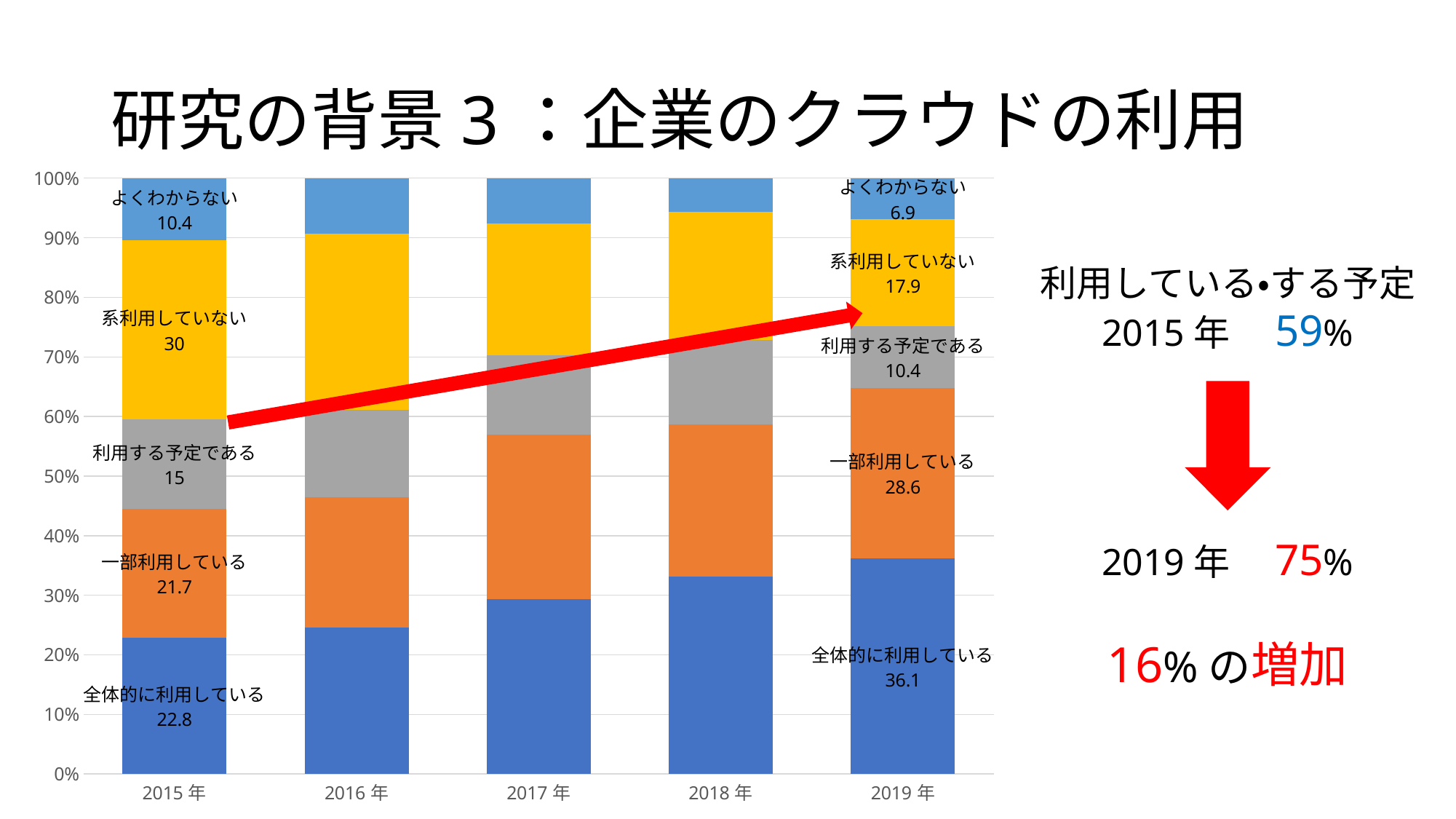
Is the 全体的に利用している segment for 2018年 greater or less than 30%? greater How many years are shown along the x axis of the chart? 5 What is the value of 一部利用している for 2019年? 28.6 What kind of chart is shown on the slide? stacked bar chart What is the value of 系利用していない for 2015年? 30 Which is larger in 2019年: 利用する予定である or 系利用していない? 系利用していない What is the value of 全体的に利用している for 2019年? 36.1 What is the difference between 系利用していない in 2015年 and in 2019年? 12.1 Does the 全体的に利用している segment rise or fall from 2015年 to 2019年? rise What is the value of よくわからない for 2019年? 6.9 What is the value of 全体的に利用している for 2015年? 22.8 By how much did 全体的に利用している increase from 2015年 to 2019年? 13.3